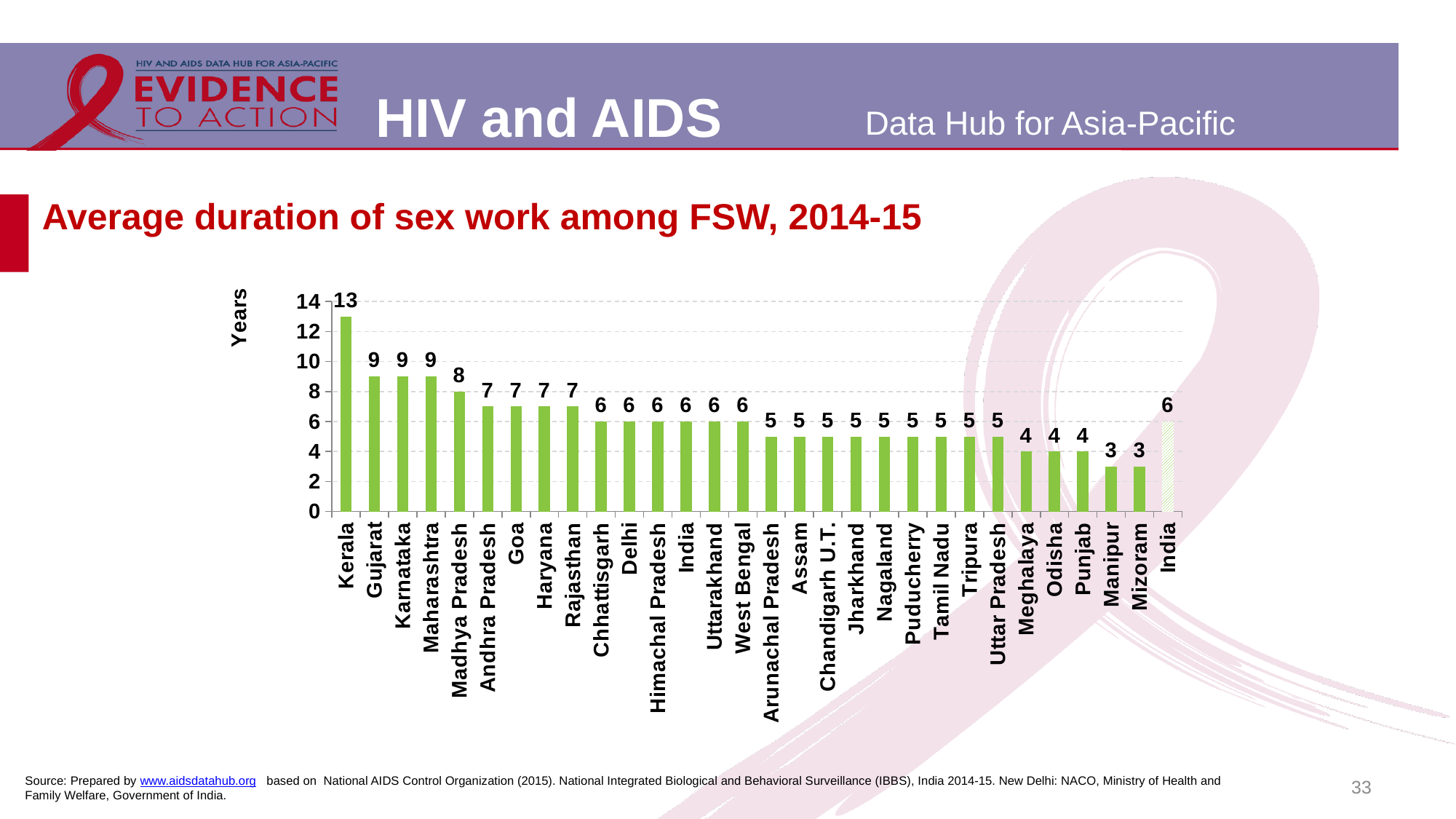
Which has a larger value, Goa or Odisha? Goa What is the difference between the values for Kerala and Gujarat? 4 Which state has the highest average duration of sex work? Kerala Do the values generally rise or fall from left to right across the states? Fall What is the average duration of sex work among FSW in Kerala? 13 How many bars are plotted in the chart? 30 What kind of chart is shown on the slide? Bar chart What value is shown for Mizoram? 3 What is the difference between the values for Madhya Pradesh and Manipur? 5 What is the label on the vertical axis of the chart? Years What value is shown for Punjab? 4 What value is shown for Madhya Pradesh? 8